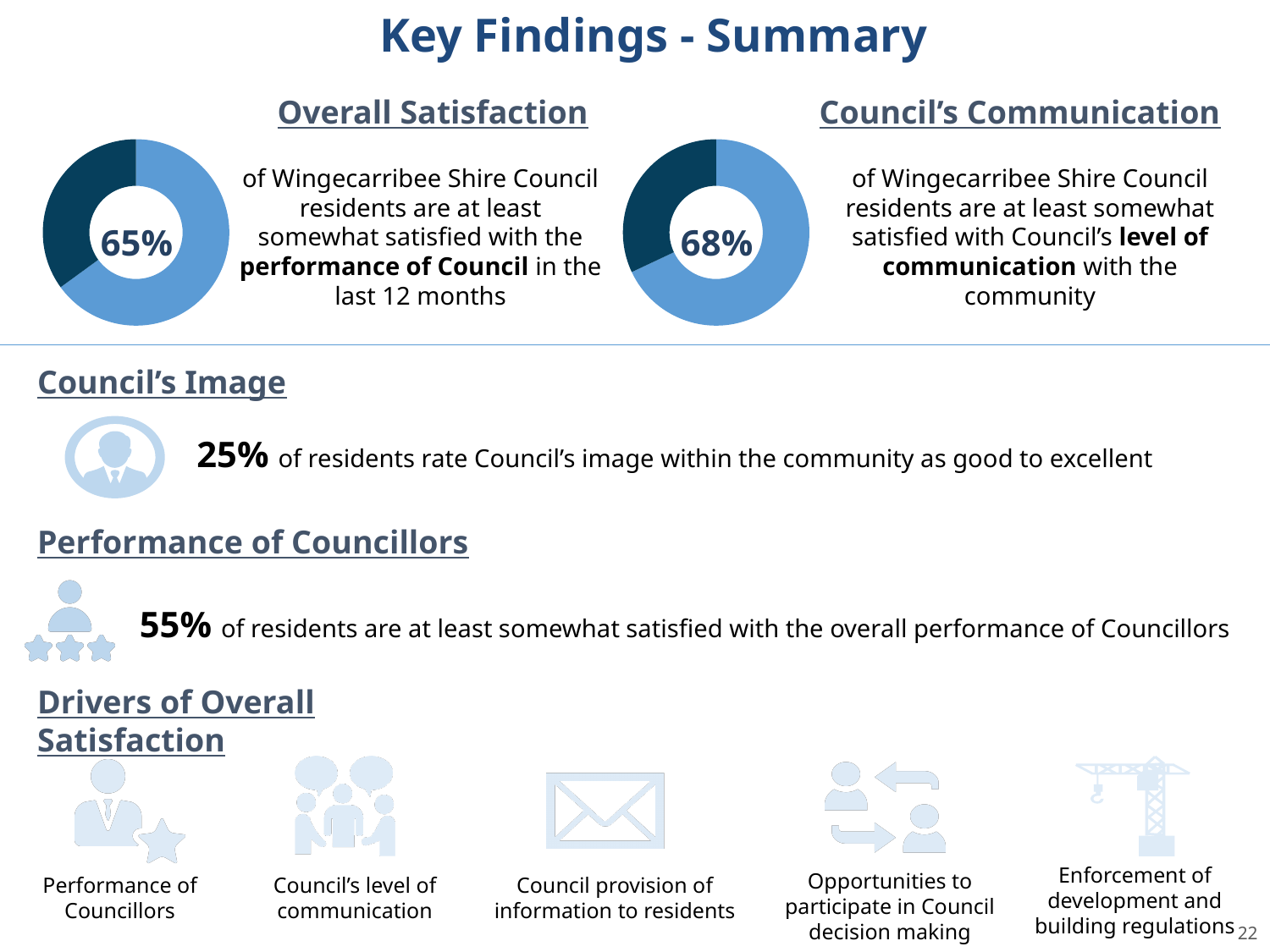
What is the title of the donut chart on the right side of the top section of the slide? Council's Communication In the Overall Satisfaction chart, what percentage of residents are at least somewhat satisfied with the performance of Council? 65% In the Council's Communication chart, what share of the donut does the light blue slice represent? 68% In the Overall Satisfaction chart, what share of the donut does the light blue slice represent? 65% In the Council's Communication chart, what percentage of residents are at least somewhat satisfied with Council's level of communication? 68% How many slices does the Council's Communication donut chart have? 2 What is the difference between the value in the Council's Communication chart (68%) and the value in the Overall Satisfaction chart (65%)? 3 percentage points In the Overall Satisfaction chart, which slice is larger: the light blue slice or the dark blue slice? The light blue slice What kind of chart is the Council's Communication chart? Donut (pie) chart What kind of chart is the Overall Satisfaction chart? Donut (pie) chart Which is larger: the value shown in the Overall Satisfaction chart or the value shown in the Council's Communication chart? Council's Communication (68%) How many slices does the Overall Satisfaction donut chart have? 2